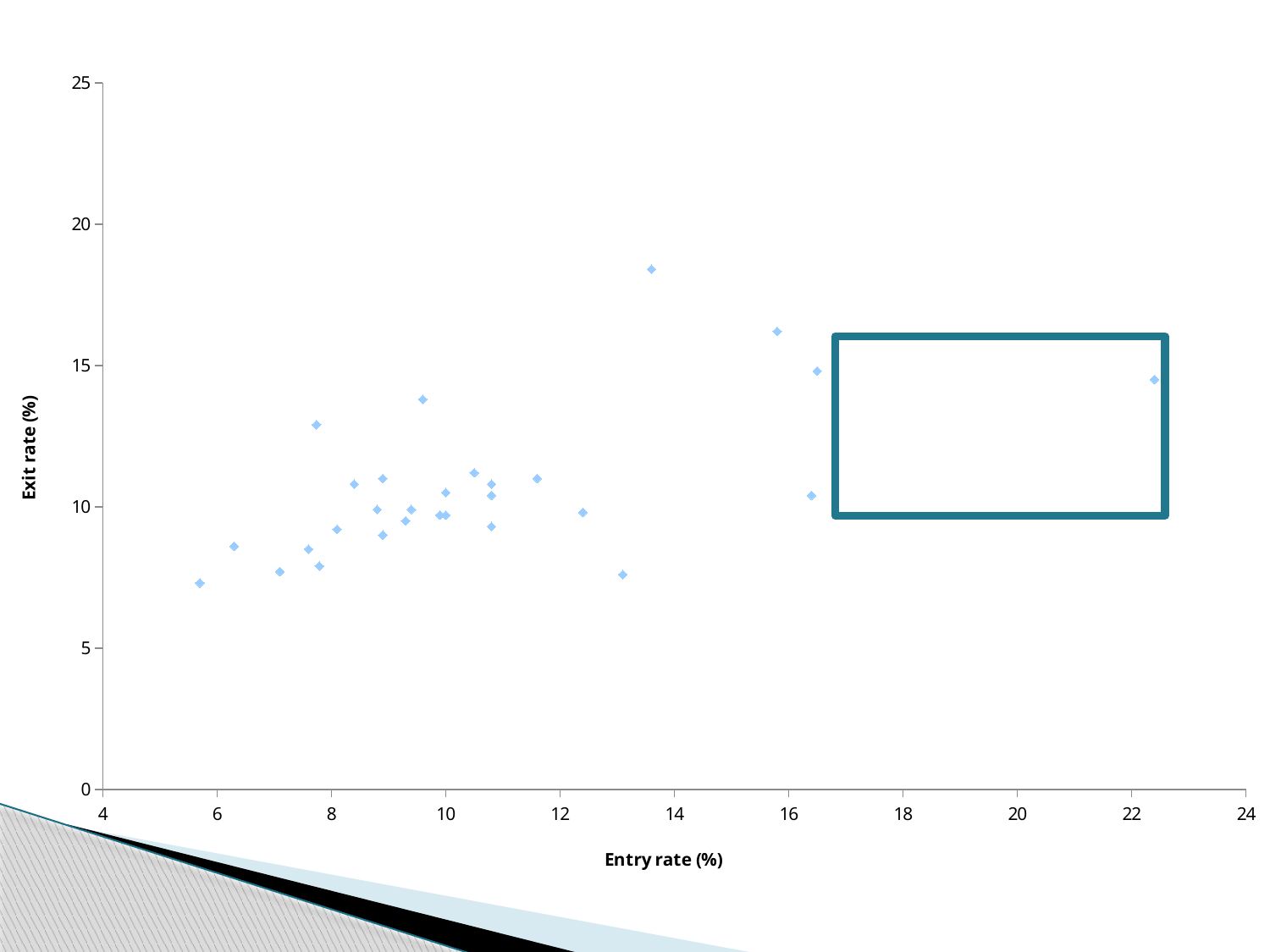
Is the exit rate of the point with the highest entry rate greater or less than 10? greater Is the exit rate of the point with the highest exit rate greater or less than 15? greater Is the entry rate of the point with the highest exit rate greater or less than 12? greater What is the label of the horizontal axis? Entry rate (%) What is the label of the vertical axis? Exit rate (%) What kind of chart is shown on the slide? scatter chart Do exit rates generally rise or fall as the entry rate increases along the x axis? rise